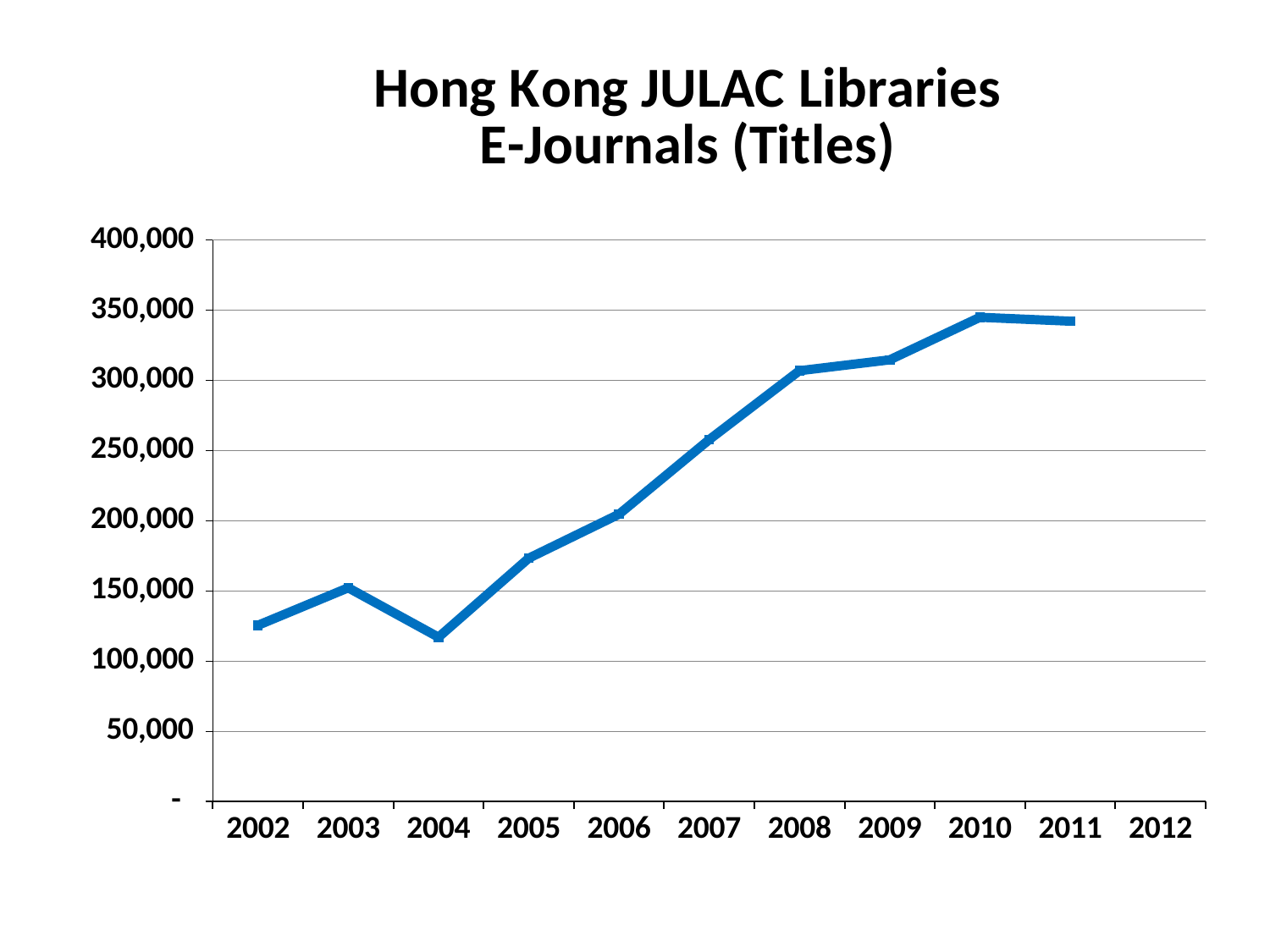
Which year has the larger value, 2003 or 2004? 2003 What kind of chart is shown on the slide? line chart Is the value for 2002 greater or less than 100,000? greater Is the value for 2007 greater or less than 300,000? less Is the value for 2005 greater or less than 150,000? greater Which year has the larger value, 2008 or 2006? 2008 Overall, do the values rise or fall from 2002 to 2011? rise What is the title of the chart? Hong Kong JULAC Libraries E-Journals (Titles) Which year has the lowest value on the chart? 2004 How many years are labelled on the x axis? 11